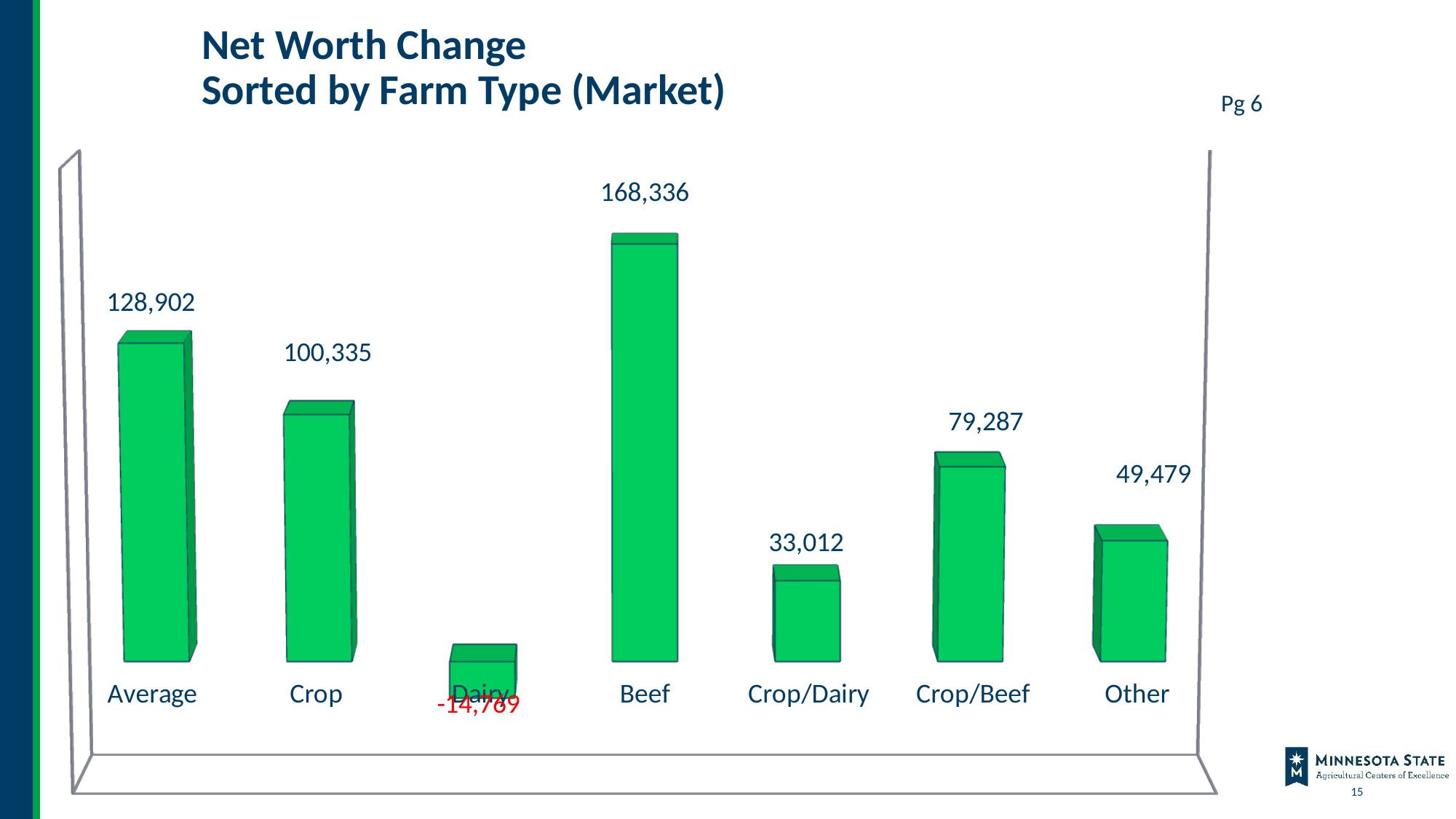
Which has a larger net worth change, Crop or Crop/Beef? Crop How many farm type categories are shown in the chart? 7 Which farm type has the highest net worth change? Beef What is the net worth change for Other? 49,479 What is the title of the chart? Net Worth Change Sorted by Farm Type (Market) Which farm type has the lowest net worth change? Dairy What kind of chart is shown on the slide? Bar chart What is the net worth change for Average? 128,902 What is the difference between the net worth change for Crop/Beef and for Other? 29,808 What is the net worth change for Crop/Dairy? 33,012 What is the difference between the net worth change for Beef and for Average? 39,434 What is the net worth change for Beef? 168,336